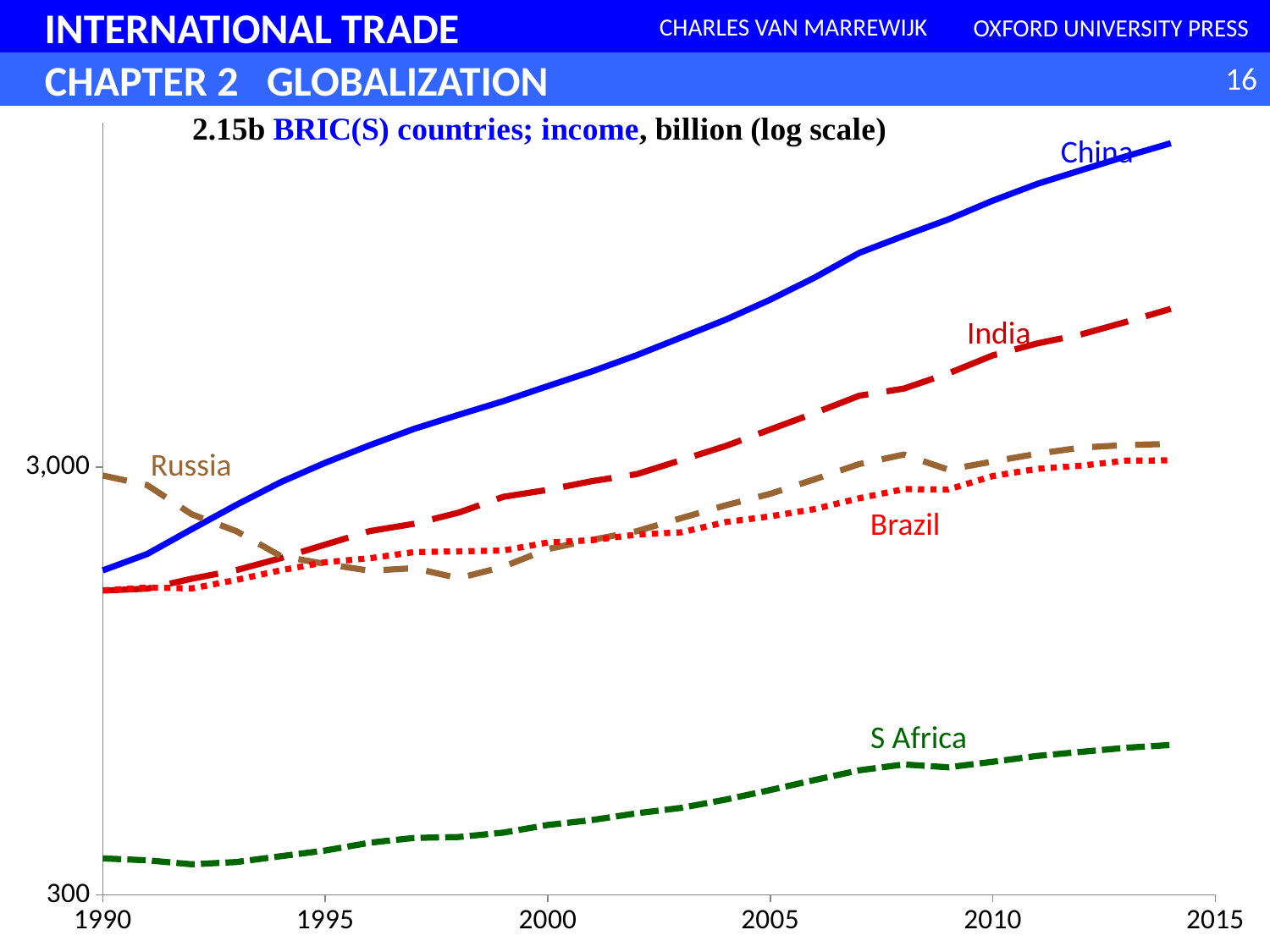
Is the value for China in 2014 greater or less than 3,000? greater Is the value for S Africa in 2014 greater or less than 3,000? less Does the line for Russia rise or fall between 1990 and 1998? falls Does the line for China rise or fall from 1990 to 2014? rises What kind of chart is shown on the slide? line chart Which is larger in 2014, the value for China or the value for India? China Is the value for India in 2014 greater or less than 3,000? greater What is the title of the chart? 2.15b BRIC(S) countries; income, billion (log scale) Which country has the highest income in 2014? China Which country has the lowest income throughout the period shown? S Africa How many countries are plotted as lines on the chart? 5